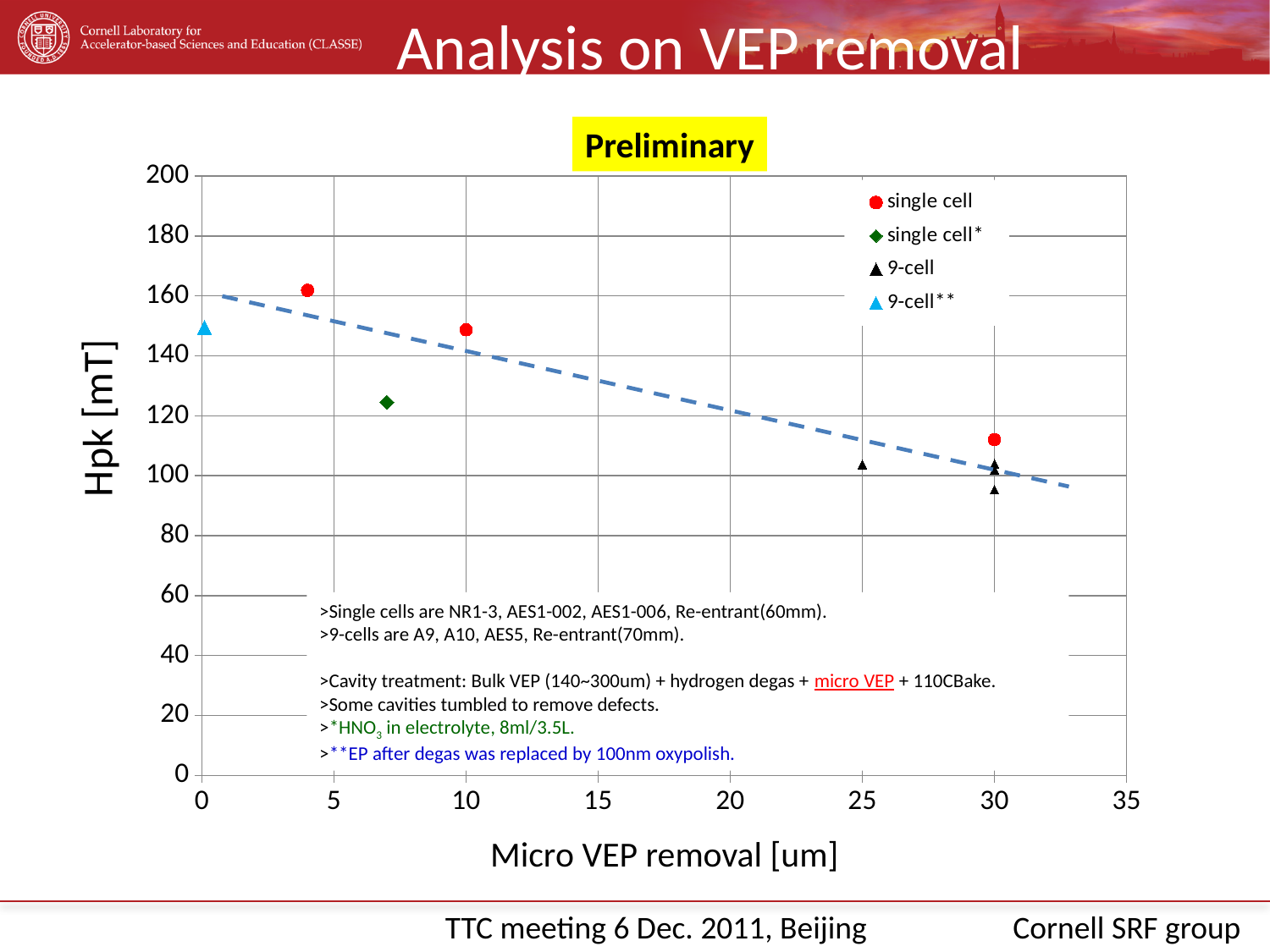
What is the label of the y axis? Hpk [mT] Do the Hpk values generally rise or fall as micro VEP removal increases along the x axis? fall Is the Hpk value for the '9-cell**' point greater or less than 140? greater What kind of chart is shown on the slide? scatter chart What is the label of the x axis? Micro VEP removal [um] Is the Hpk value for the 'single cell*' point greater or less than 140? less Which series contains the point with the lowest Hpk value? 9-cell How many data points are plotted for the '9-cell**' series? 1 Which series contains the point with the highest Hpk value? single cell How many data points are plotted for the 'single cell*' series? 1 Is the Hpk value for the '9-cell' point at 25 um removal greater or less than 120? less How many series does the legend list? 4